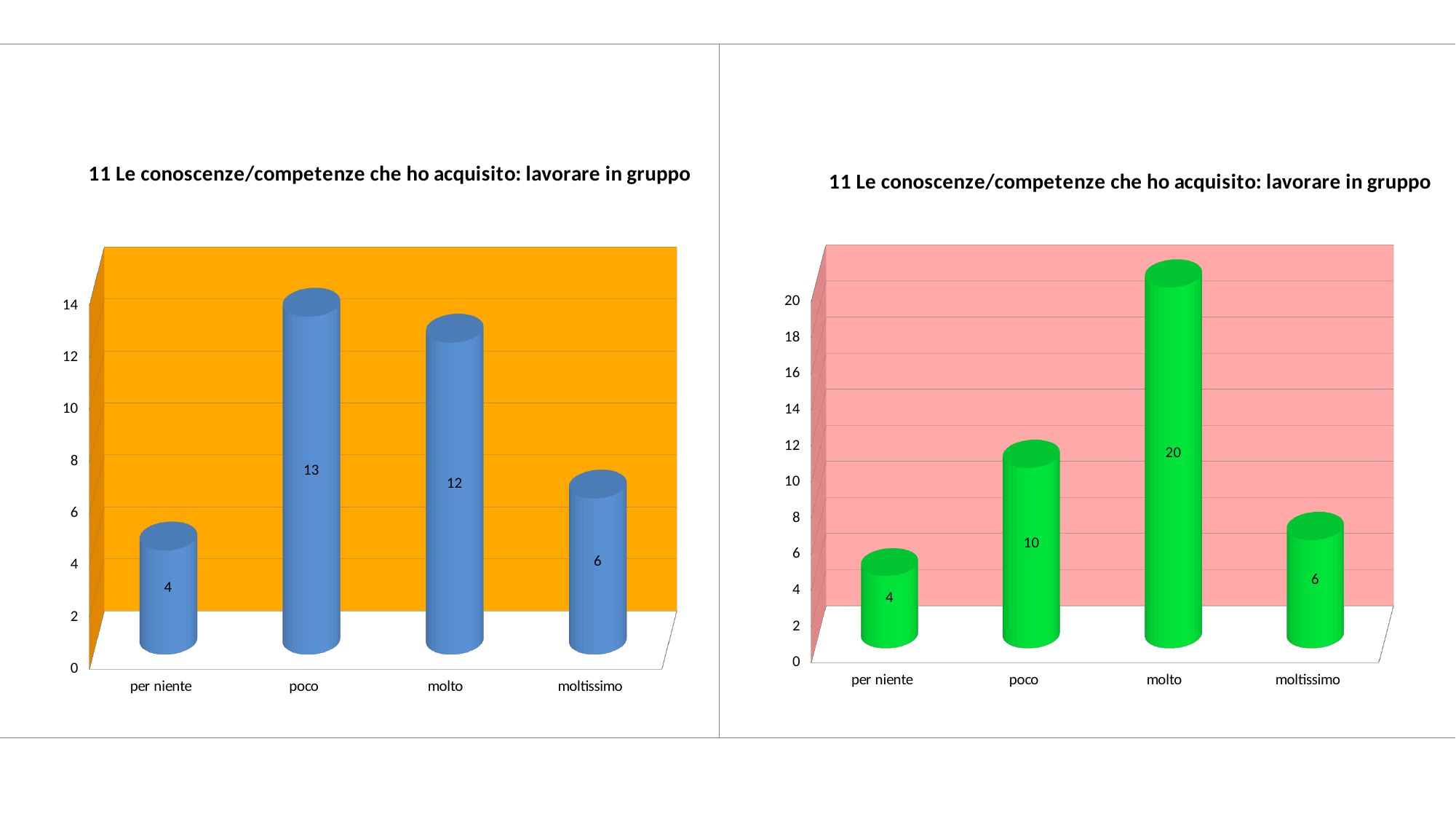
What kind of chart is the left chart? bar chart In the left chart, what is the difference between the values for poco and moltissimo? 7 In the left chart, which is larger, the value for molto or the value for moltissimo? molto In the left chart, what is the value for moltissimo? 6 In the right chart, which category has the lowest value? per niente In the left chart, which category has the highest value? poco In the right chart, what is the value for molto? 20 How many categories are shown on the x axis of the right chart? 4 In the left chart, what is the value for poco? 13 What is the title of the right chart? 11 Le conoscenze/competenze che ho acquisito: lavorare in gruppo In the right chart, what is the difference between the values for molto and poco? 10 In the right chart, is the value for poco greater or less than 8? greater